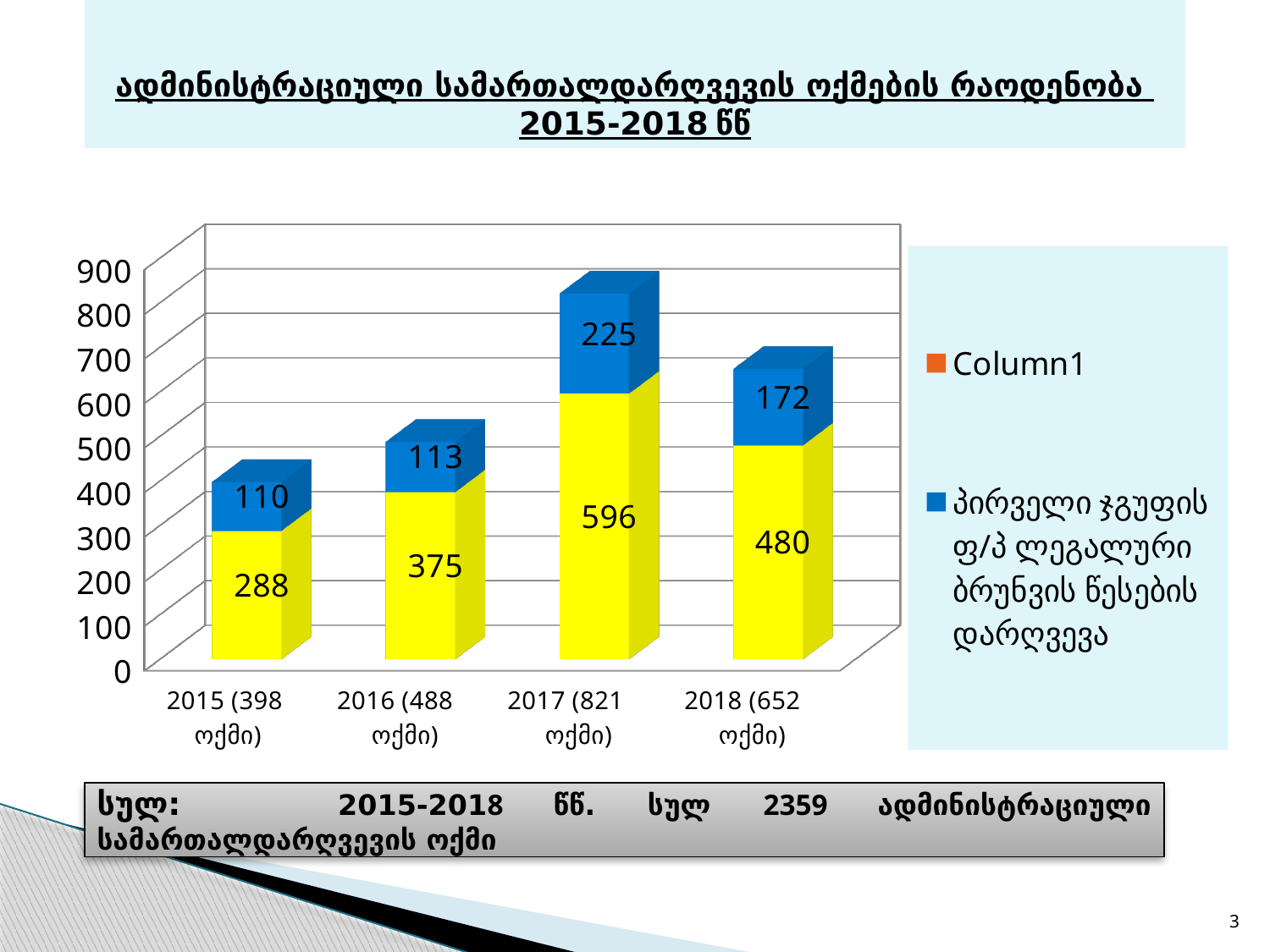
What kind of chart is shown on the slide? stacked bar chart Is the total height of the 2018 bar greater or less than 600? greater What is the value of the blue segment for 2018 (652 ოქმი)? 172 What is the value of the blue segment for 2015 (398 ოქმი)? 110 Which category has the lowest blue segment value? 2015 (398 ოქმი) How many entries does the legend list? 2 What is the value of the yellow segment for 2017 (821 ოქმი)? 596 How many categories are shown on the x axis? 4 Which is larger: the blue segment for 2017 or the blue segment for 2018? 2017 Which category has the highest yellow segment value? 2017 (821 ოქმი) What is the difference between the yellow segment values for 2017 and 2016? 221 What is the total of the stacked bar for 2017? 821